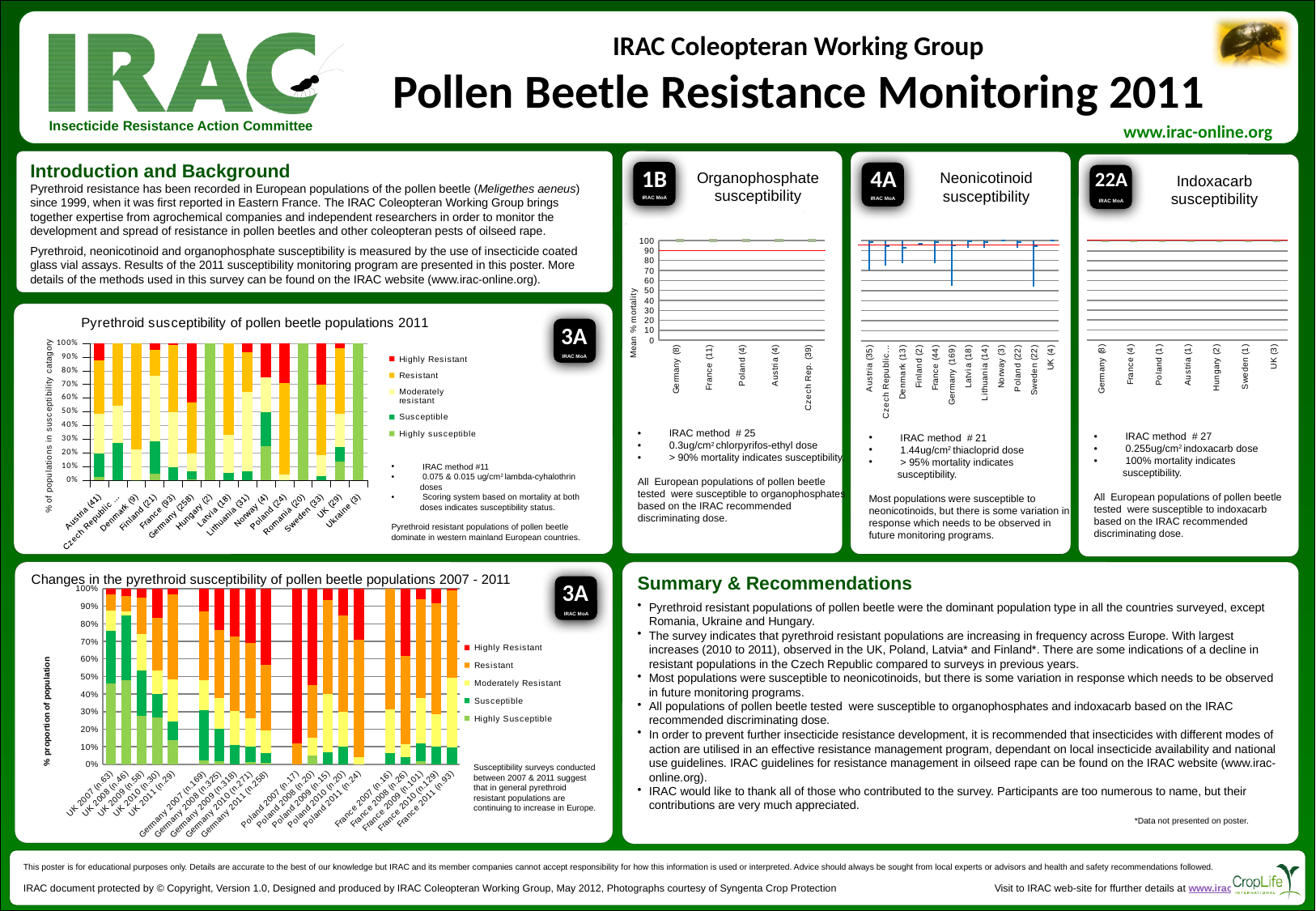
In the 'Neonicotinoid susceptibility' chart, how many populations are plotted on the x axis? 12 In the 'Organophosphate susceptibility' chart, how many populations are plotted on the x axis? 5 In the chart titled 'Pyrethroid susceptibility of pollen beetle populations 2011', is the Highly susceptible share for Hungary (2) greater or less than 50%? greater In the 'Indoxacarb susceptibility' chart, how many populations are plotted on the x axis? 7 In the chart titled 'Changes in the pyrethroid susceptibility of pollen beetle populations 2007 - 2011', how many series does the legend list? 5 In the 'Organophosphate susceptibility' chart, what is the label on the y axis? Mean % mortality In the 'Organophosphate susceptibility' chart, is the mean % mortality for Czech Rep. (39) greater or less than 90? greater In the chart titled 'Changes in the pyrethroid susceptibility of pollen beetle populations 2007 - 2011', what colour represents the 'Highly Resistant' series in the legend? Red In the chart titled 'Pyrethroid susceptibility of pollen beetle populations 2011', what kind of chart is shown? Stacked bar chart In the chart titled 'Pyrethroid susceptibility of pollen beetle populations 2011', how many series does the legend list? 5